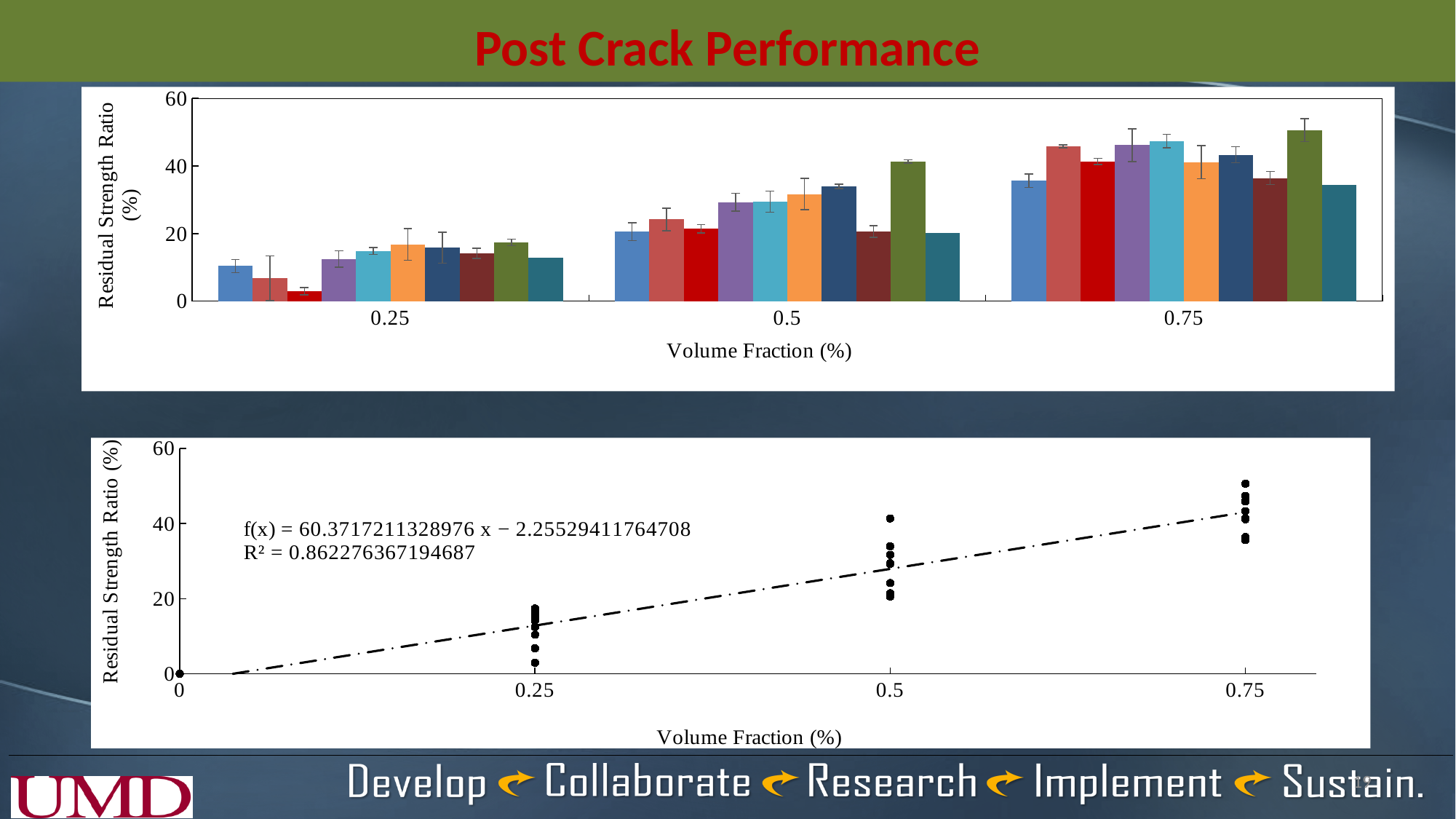
What kind of chart is the bottom chart on the slide? scatter chart In the bottom chart, what is the R² value shown for the trendline? 0.862276367194687 In the top chart, which volume fraction group has the lowest bars overall? 0.25 In the top chart, what is the title of the x axis? Volume Fraction (%) What kind of chart is the top chart on the slide? bar chart In the bottom chart, what is the trendline equation shown? f(x) = 60.3717211328976 x − 2.25529411764708 In the top chart, how many volume fraction categories are shown on the x axis? 3 In the top chart, do the residual strength ratios generally rise or fall as the volume fraction increases from 0.25 to 0.75? rise In the top chart, is the tallest bar in the 0.75 group greater or less than 40? greater In the top chart, is the tallest bar in the 0.25 group greater or less than 20? less In the bottom chart, are the points at volume fraction 0.75 greater or less than 20? greater In the bottom chart, do the plotted points rise or fall as volume fraction increases? rise